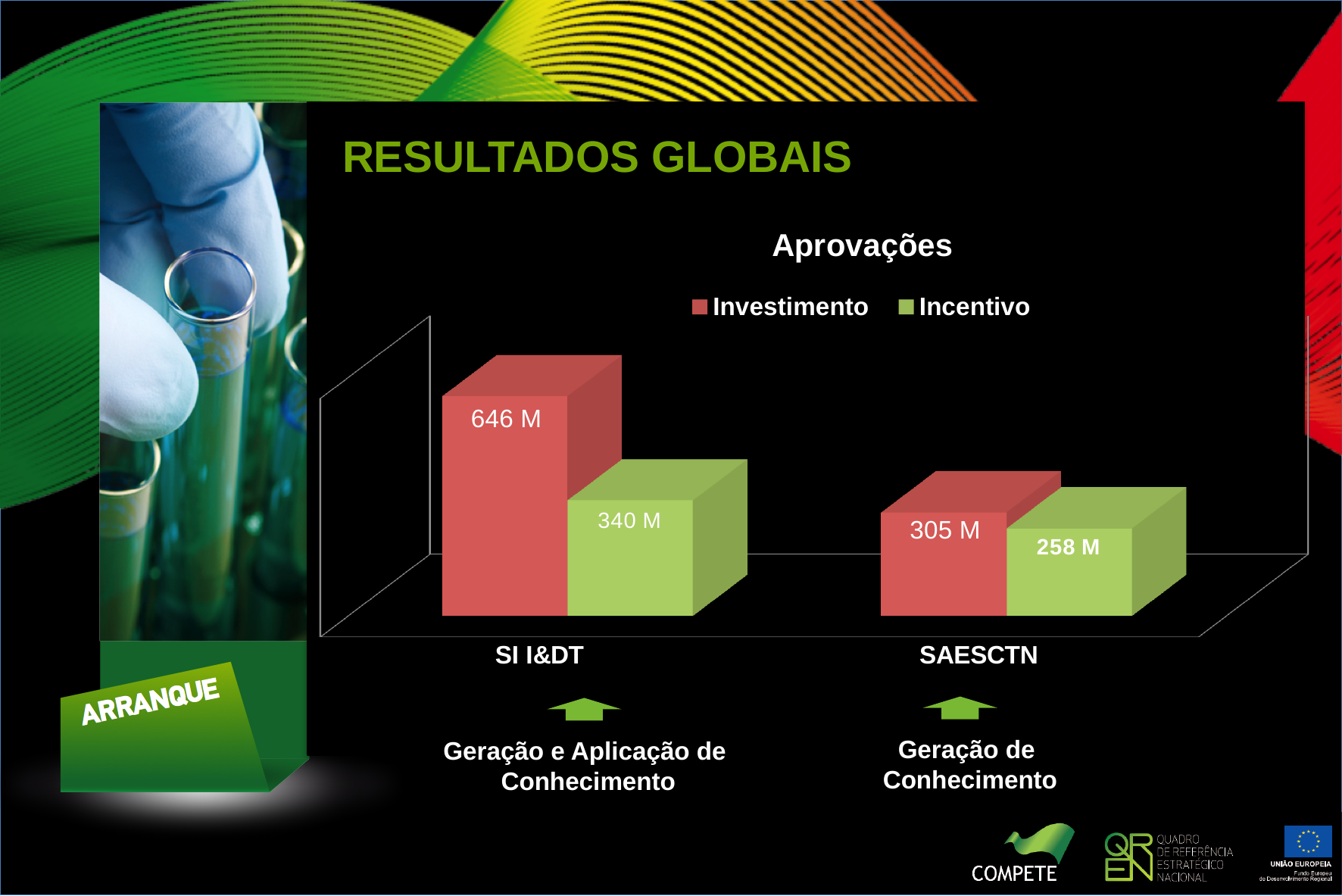
What is the difference between the Investimento values for SI I&DT and SAESCTN? 341 M Which category has the highest Investimento value? SI I&DT How many categories are shown on the x axis? 2 Which category has the lowest Incentivo value? SAESCTN What is the difference between Investimento and Incentivo for SI I&DT? 306 M What is the Investimento value for SI I&DT? 646 M Which is larger for SAESCTN, Investimento or Incentivo? Investimento What is the Incentivo value for SI I&DT? 340 M What is the Investimento value for SAESCTN? 305 M What is the title of the chart? Aprovações How many series does the legend list? 2 What is the Incentivo value for SAESCTN? 258 M